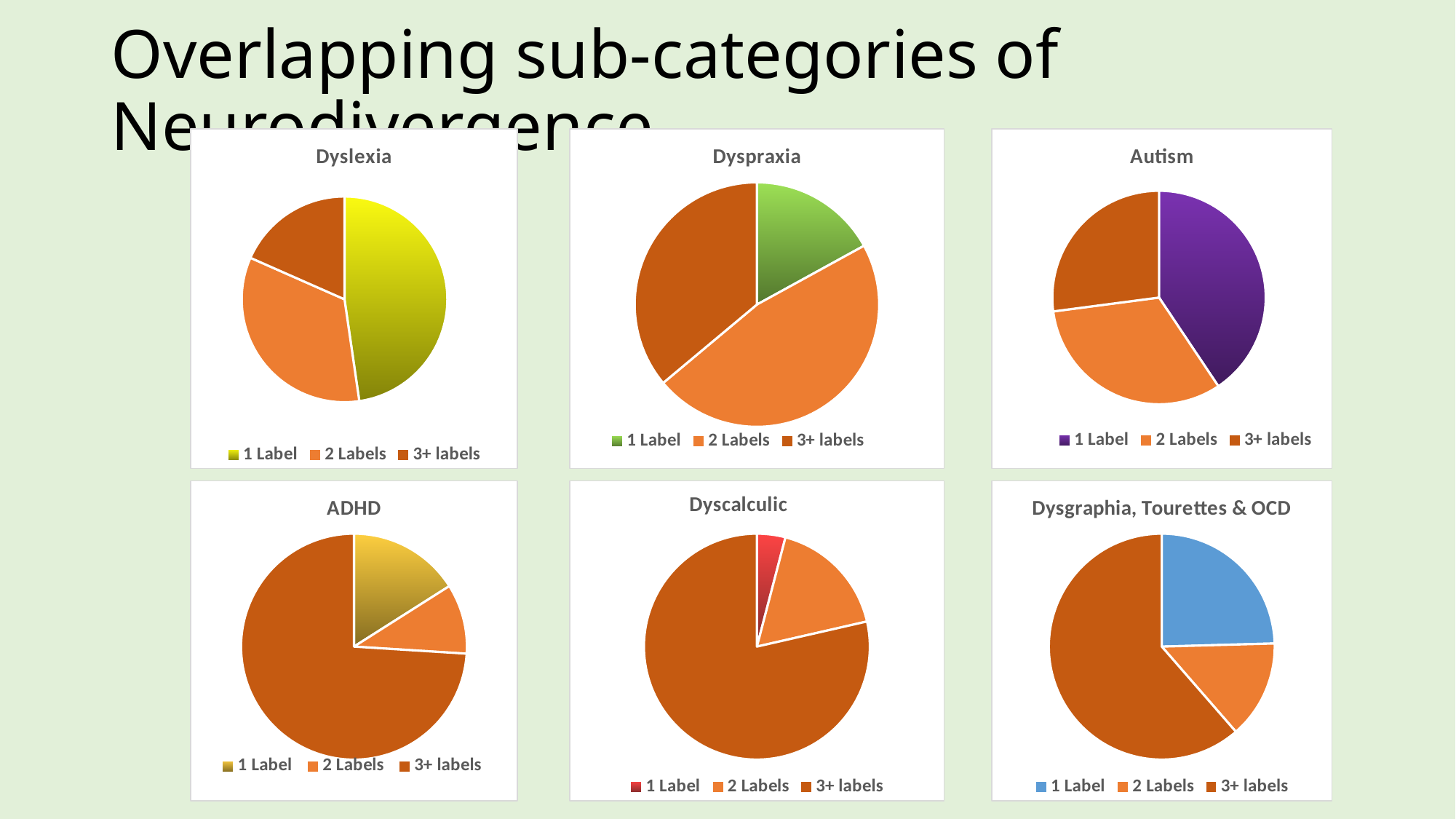
In the Dyscalculic chart, which category has the smallest slice? 1 Label In the Dysgraphia, Tourettes & OCD chart, is the slice for 1 Label or 2 Labels larger? 1 Label In the Dyspraxia chart, which category has the smallest slice? 1 Label What kind of chart is used for Dyslexia? Pie chart In the Dyslexia chart, which category has the largest slice? 1 Label In the Dyslexia chart, which category has the smallest slice? 3+ labels In the Dyspraxia chart, which category has the largest slice? 2 Labels In the Autism chart, which category has the largest slice? 1 Label What colour is the 1 Label slice in the Autism chart? Purple How many pie charts are shown on the slide? 6 How many entries does the legend of the Dyspraxia chart list? 3